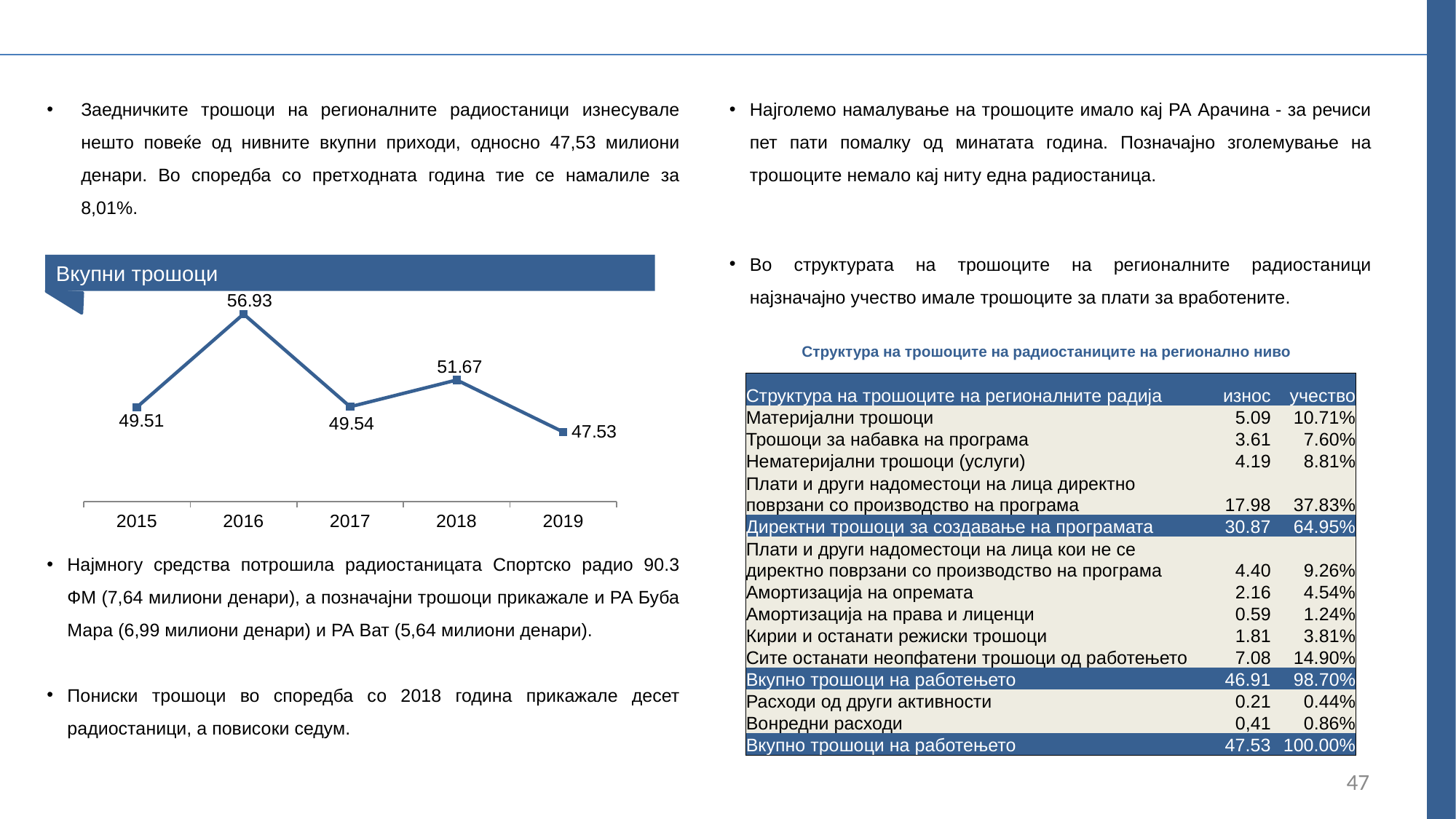
Which year has the highest value in the "Вкупни трошоци" chart? 2016 What type of chart is shown under the title "Вкупни трошоци"? line chart In the "Вкупни трошоци" chart, which is larger: the value for 2018 or the value for 2019? 2018 In the "Вкупни трошоци" chart, does the value rise or fall from 2018 to 2019? fall Which year has the lowest value in the "Вкупни трошоци" chart? 2019 What is the value for 2015 in the "Вкупни трошоци" chart? 49.51 What is the difference between the 2018 and 2017 values in the "Вкупни трошоци" chart? 2.13 What is the value for 2018 in the "Вкупни трошоци" chart? 51.67 How many years are plotted in the "Вкупни трошоци" chart? 5 What is the value for 2019 in the "Вкупни трошоци" chart? 47.53 What is the value for 2016 in the "Вкупни трошоци" chart? 56.93 What is the difference between the 2016 and 2019 values in the "Вкупни трошоци" chart? 9.40